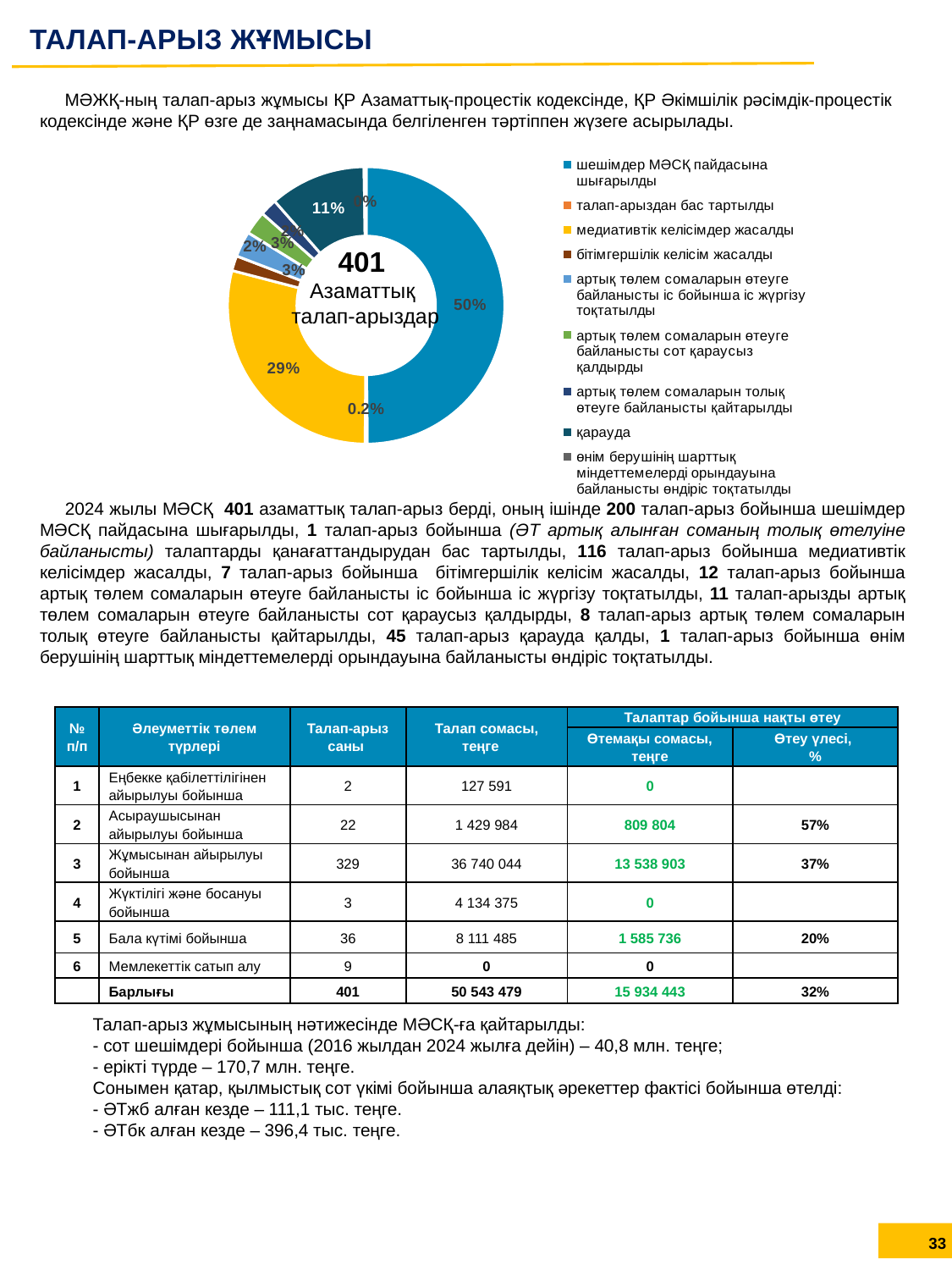
What is the difference in percentage points between 'медиативтік келісімдер жасалды' (29%) and 'қарауда' (11%)? 18% What is the percentage shown for 'медиативтік келісімдер жасалды'? 29% What is the difference in percentage points between 'шешімдер МӘСҚ пайдасына шығарылды' (50%) and 'медиативтік келісімдер жасалды' (29%)? 21% How many entries does the chart legend list? 9 What text accompanies the number in the centre of the doughnut chart? Азаматтық талап-арыздар What is the percentage shown for 'қарауда'? 11% What is the percentage shown for 'шешімдер МӘСҚ пайдасына шығарылды'? 50% Which category has the largest share of the chart? шешімдер МӘСҚ пайдасына шығарылды What kind of chart is shown on the slide? Doughnut (pie) chart Which is larger: the share for 'медиативтік келісімдер жасалды' or the share for 'қарауда'? медиативтік келісімдер жасалды What number is displayed in the centre of the doughnut chart? 401 What is the percentage shown for 'талап-арыздан бас тартылды'? 0.2%